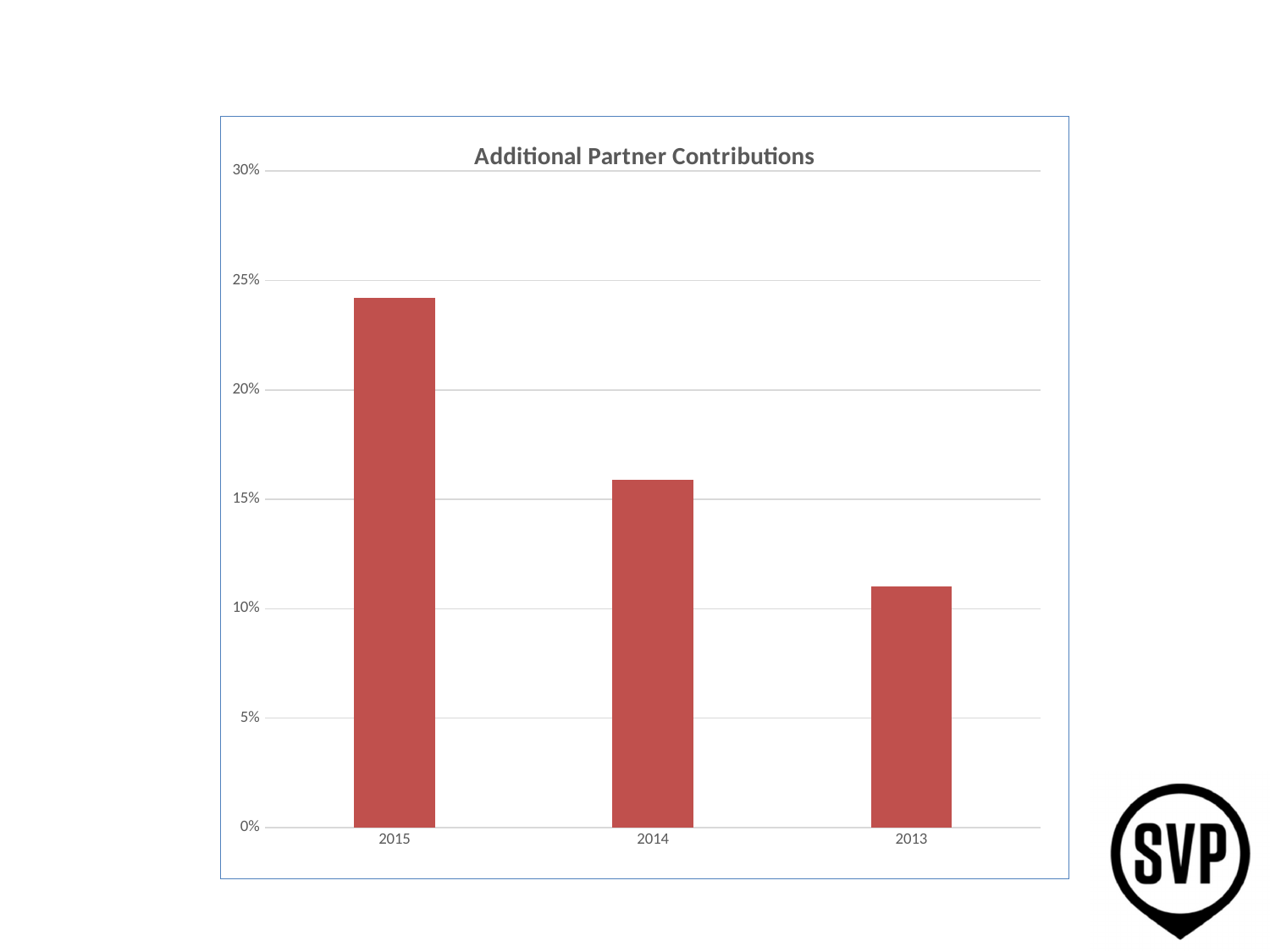
How many categories are plotted on the x axis? 3 What kind of chart is shown on the slide? bar chart Is the value for 2013 greater or less than 15%? less Is the value for 2014 greater or less than 15%? greater Which year has the highest value? 2015 Is the value for 2015 greater or less than 20%? greater What is the title of the chart? Additional Partner Contributions Do the values rise or fall moving left to right along the x axis from 2015 to 2013? fall Which year has the lowest value? 2013 Which is larger, the value for 2014 or the value for 2013? 2014